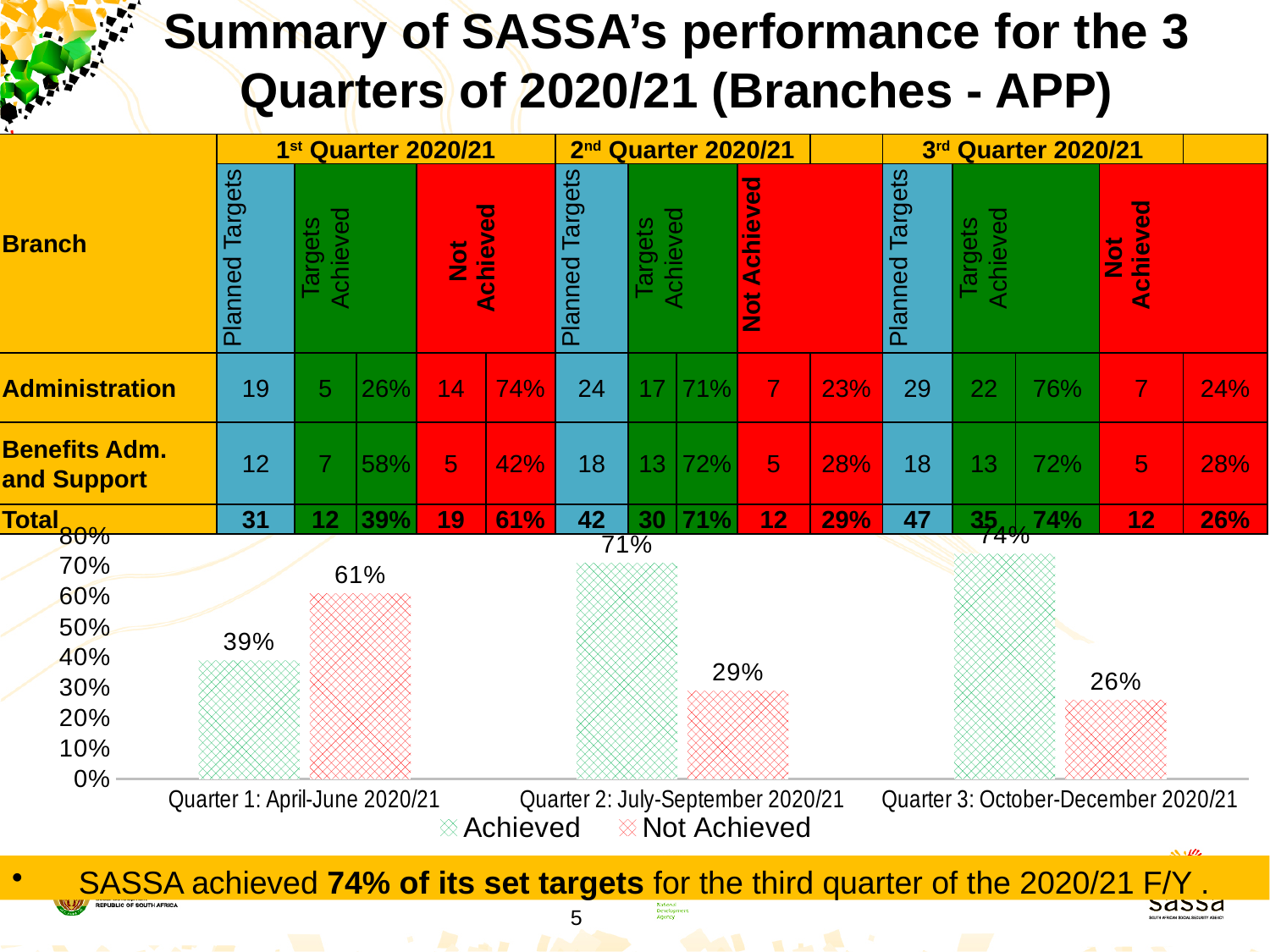
What is the Achieved value for Quarter 1: April-June 2020/21 in the chart? 39% Which is larger for Quarter 2: July-September 2020/21, the Achieved value or the Not Achieved value? Achieved Which quarter has the highest Achieved value in the chart? Quarter 3: October-December 2020/21 What is the difference between the Not Achieved and Achieved values for Quarter 1: April-June 2020/21? 22% What is the Not Achieved value for Quarter 2: July-September 2020/21 in the chart? 29% Does the Achieved value rise or fall from Quarter 1 to Quarter 3 in the chart? rise How many series does the chart legend list? 2 How many quarters are shown on the x axis of the chart? 3 What kind of chart is shown on the slide? bar chart Is the Not Achieved value for Quarter 1: April-June 2020/21 greater or less than 50%? greater Which quarter has the lowest Not Achieved value in the chart? Quarter 3: October-December 2020/21 What is the Achieved value for Quarter 3: October-December 2020/21 in the chart? 74%